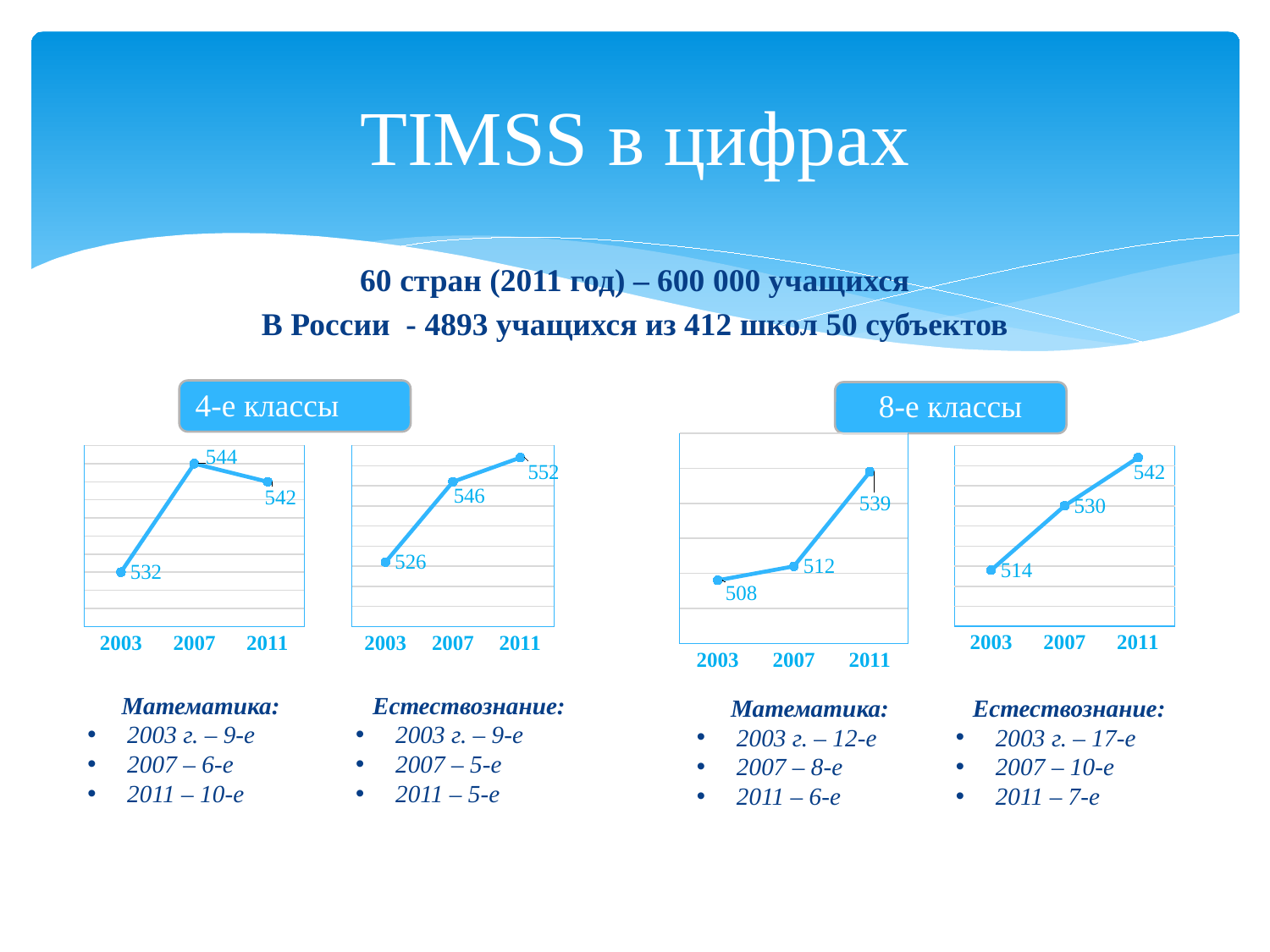
In the 8th-grade mathematics chart (third from left), which year has the lowest value? 2003 In the 4th-grade mathematics chart (leftmost), which year has the highest value? 2007 In the 8th-grade mathematics chart (third from left), what is the difference between the 2011 and 2007 values? 27 What type of chart is the 8th-grade science chart (rightmost)? line chart In the 8th-grade science chart (rightmost), do the values rise or fall from 2003 to 2011? rise In the 4th-grade mathematics chart (leftmost), what is the value for 2003? 532 In the 4th-grade science chart (second from left), what is the value for 2011? 552 How many data points are plotted in the 4th-grade mathematics chart (leftmost)? 3 In the 4th-grade mathematics chart (leftmost), what is the value for 2007? 544 In the 8th-grade science chart (rightmost), what is the value for 2007? 530 In the 8th-grade mathematics chart (third from left), what is the value for 2003? 508 In the 4th-grade science chart (second from left), what is the difference between the 2011 and 2003 values? 26